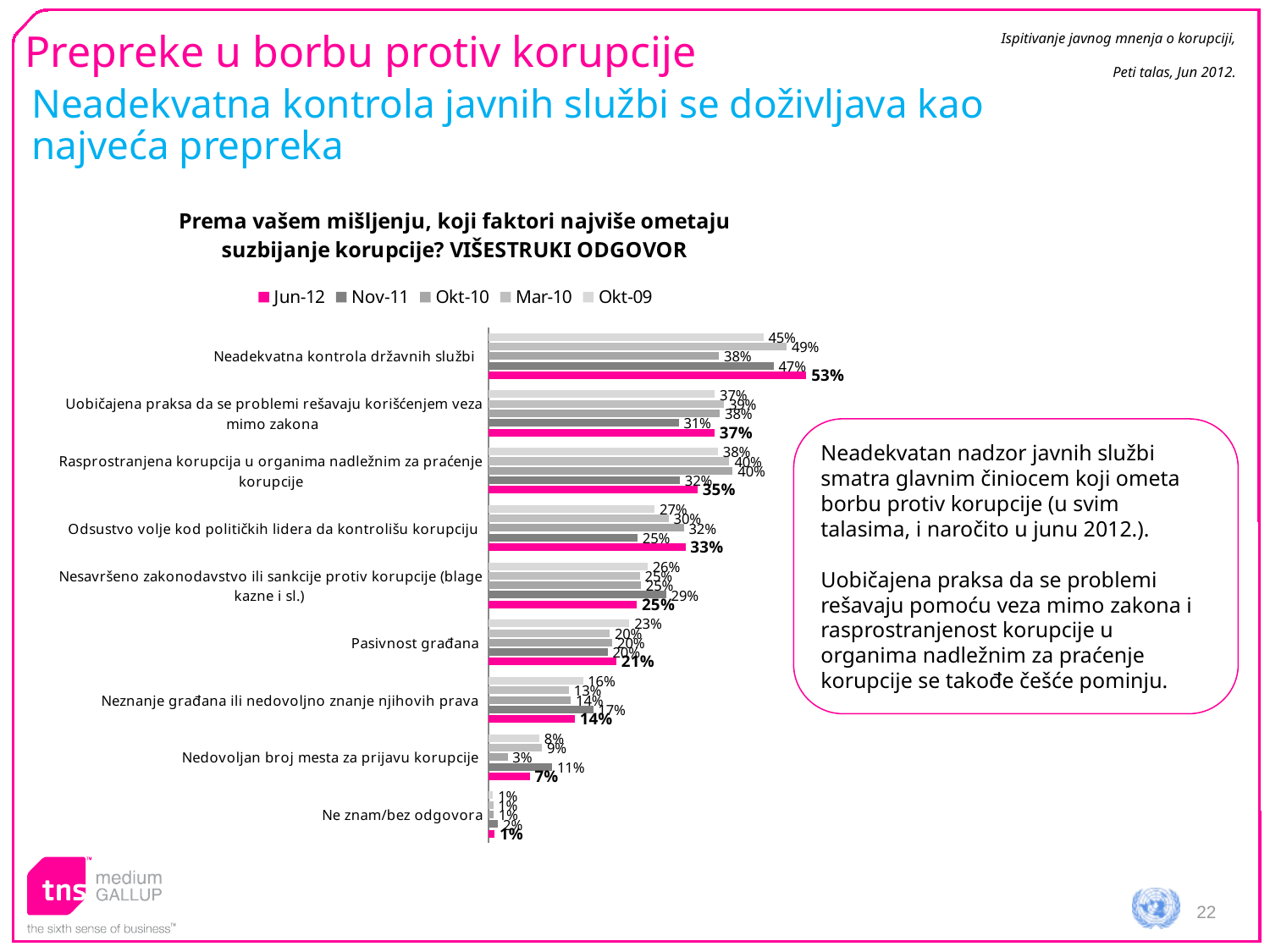
Which category has the lowest Jun-12 value? Ne znam/bez odgovora Which series is shown in pink in the legend? Jun-12 What kind of chart is shown on the slide? Bar chart For Jun-12, which is larger: "Rasprostranjena korupcija u organima nadležnim za praćenje korupcije" or "Odsustvo volje kod političkih lidera da kontrolišu korupciju"? Rasprostranjena korupcija u organima nadležnim za praćenje korupcije Which category has the highest Jun-12 value? Neadekvatna kontrola državnih službi What is the difference between the Jun-12 values for "Neadekvatna kontrola državnih službi" and "Uobičajena praksa da se problemi rešavaju korišćenjem veza mimo zakona"? 16 percentage points What is the Jun-12 value for "Neznanje građana ili nedovoljno znanje njihovih prava"? 14% What is the Jun-12 value for "Neadekvatna kontrola državnih službi"? 53% What is the Jun-12 value for "Nedovoljan broj mesta za prijavu korupcije"? 7% What is the Jun-12 value for "Pasivnost građana"? 21% How many categories are shown on the chart? 9 How many series does the legend list? 5